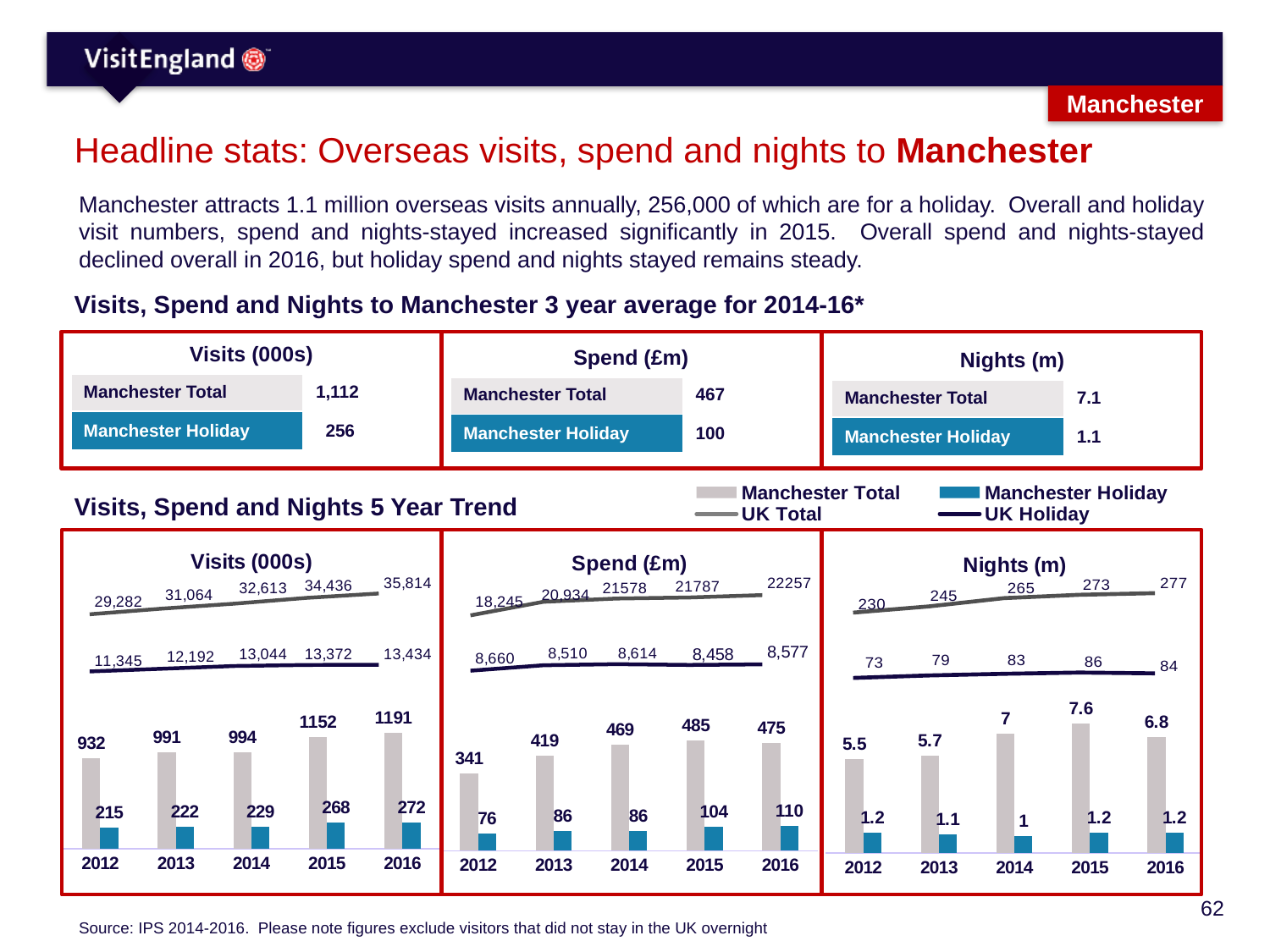
What kind of chart is used for the Manchester Total and Manchester Holiday series in the Visits (000s) chart? Bar chart In the Spend (£m) chart, what is the Manchester Holiday value for 2015? 104 In the Visits (000s) chart, what is the Manchester Total value for 2016? 1191 In the Spend (£m) chart, which year has the highest Manchester Total value? 2015 In the Nights (m) chart, which year has the lowest Manchester Holiday value? 2014 In the Spend (£m) chart, is the Manchester Total value larger in 2015 or 2016? 2015 In the Visits (000s) chart, what is the difference between the Manchester Total values for 2016 and 2012? 259 In the Spend (£m) chart, what is the UK Holiday value for 2012? 8,660 How many years are shown on the x axis of the Nights (m) chart? 5 In the Nights (m) chart, what is the UK Total value for 2014? 265 In the Visits (000s) chart, does the UK Total line rise or fall from 2012 to 2016? Rise How many series does the legend above the 5 Year Trend charts list? 4